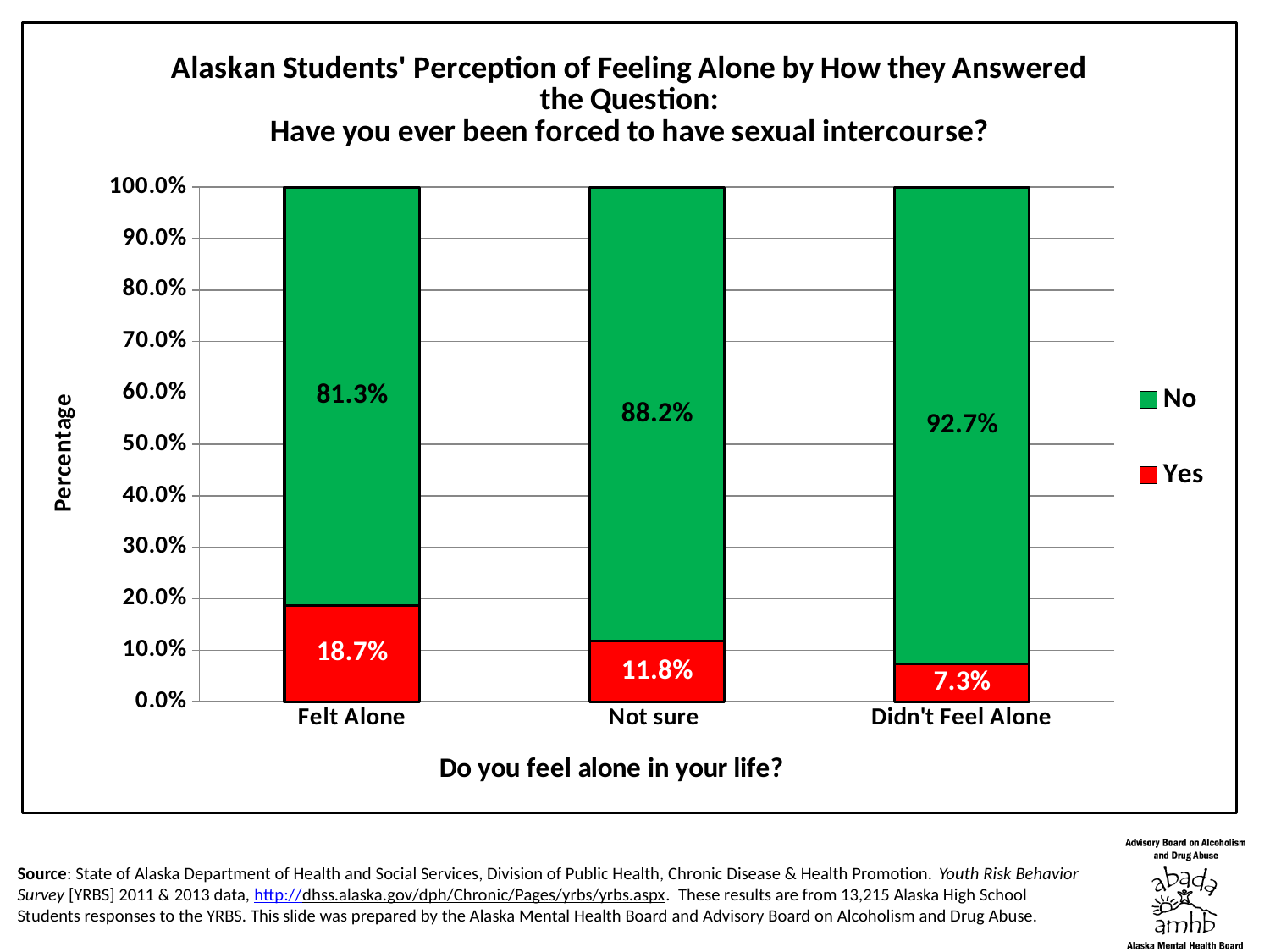
Do the 'Yes' values rise or fall moving from 'Felt Alone' to 'Didn't Feel Alone'? Fall What is the 'Yes' value for the 'Felt Alone' category? 18.7% Which category has the highest 'Yes' value? Felt Alone What is the 'No' value for the 'Not sure' category? 88.2% Which category has the lowest 'No' value? Felt Alone What kind of chart is shown on the slide? Stacked bar chart How many series does the legend list? 2 What is the difference between the 'Yes' values for 'Felt Alone' and 'Didn't Feel Alone'? 11.4% What is the total of the stacked bar for 'Not sure'? 100.0% What is the 'Yes' value for the 'Didn't Feel Alone' category? 7.3% Which is larger: the 'No' value for 'Not sure' or the 'No' value for 'Didn't Feel Alone'? Didn't Feel Alone How many categories are shown on the x axis? 3